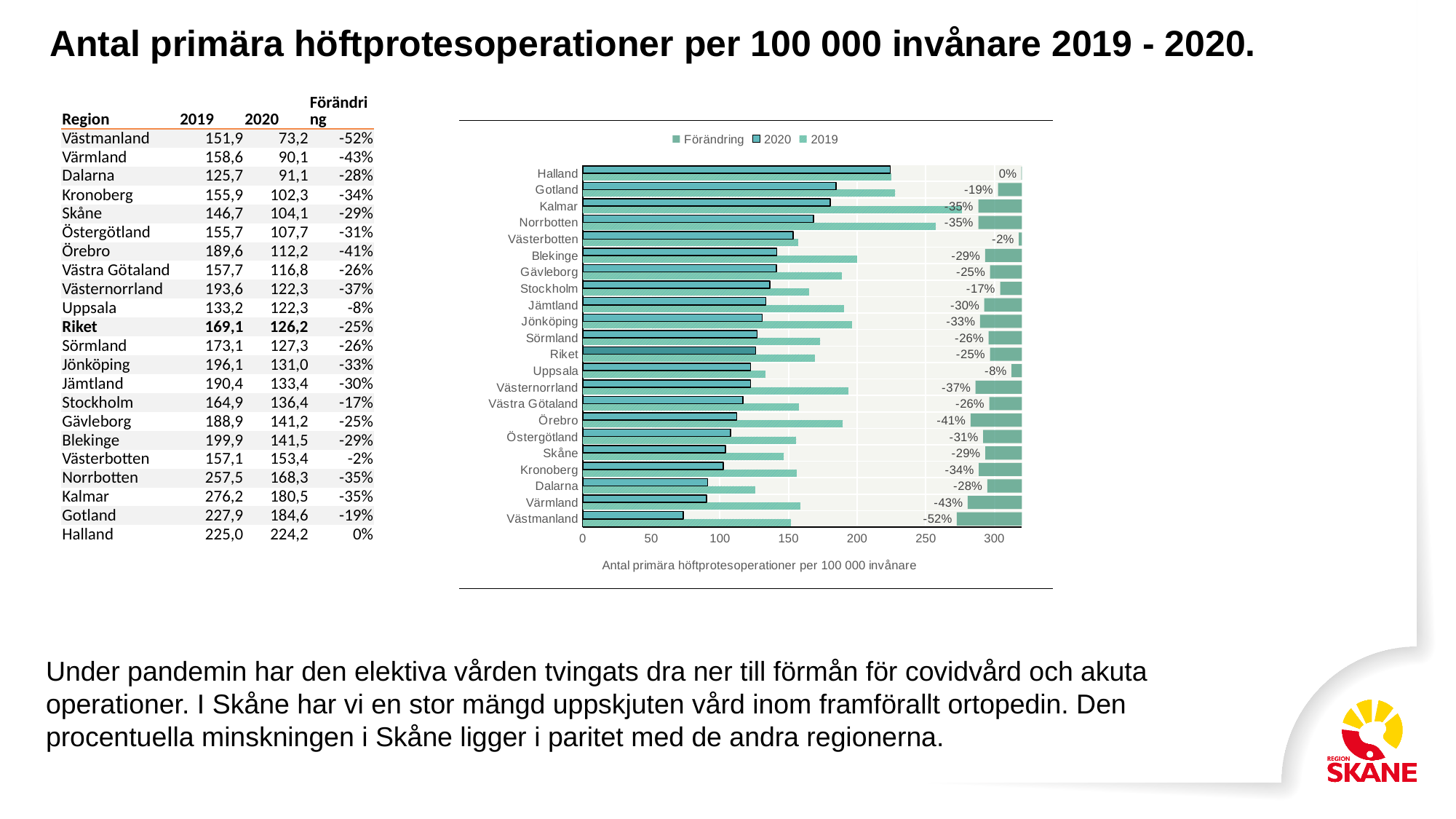
What is the Förändring value shown for Halland on the chart? 0% What is the difference in percentage points between the Förändring values for Värmland (-43%) and Västmanland (-52%)? 9 percentage points Is the 2019 bar for Kalmar greater or less than 250? greater What is the Förändring value shown for Skåne on the chart? -29% How many regions (categories) are plotted on the chart? 22 What is the title shown below the x axis of the chart? Antal primära höftprotesoperationer per 100 000 invånare Is the 2020 bar for Västmanland greater or less than 100? less Which region has the largest percentage decrease (lowest Förändring value) on the chart? Västmanland What kind of chart is shown on the slide? bar chart What is the Förändring value shown for Västmanland on the chart? -52% How many series does the chart's legend list? 3 Which region has the longer 2019 bar, Norrbotten or Gotland? Norrbotten